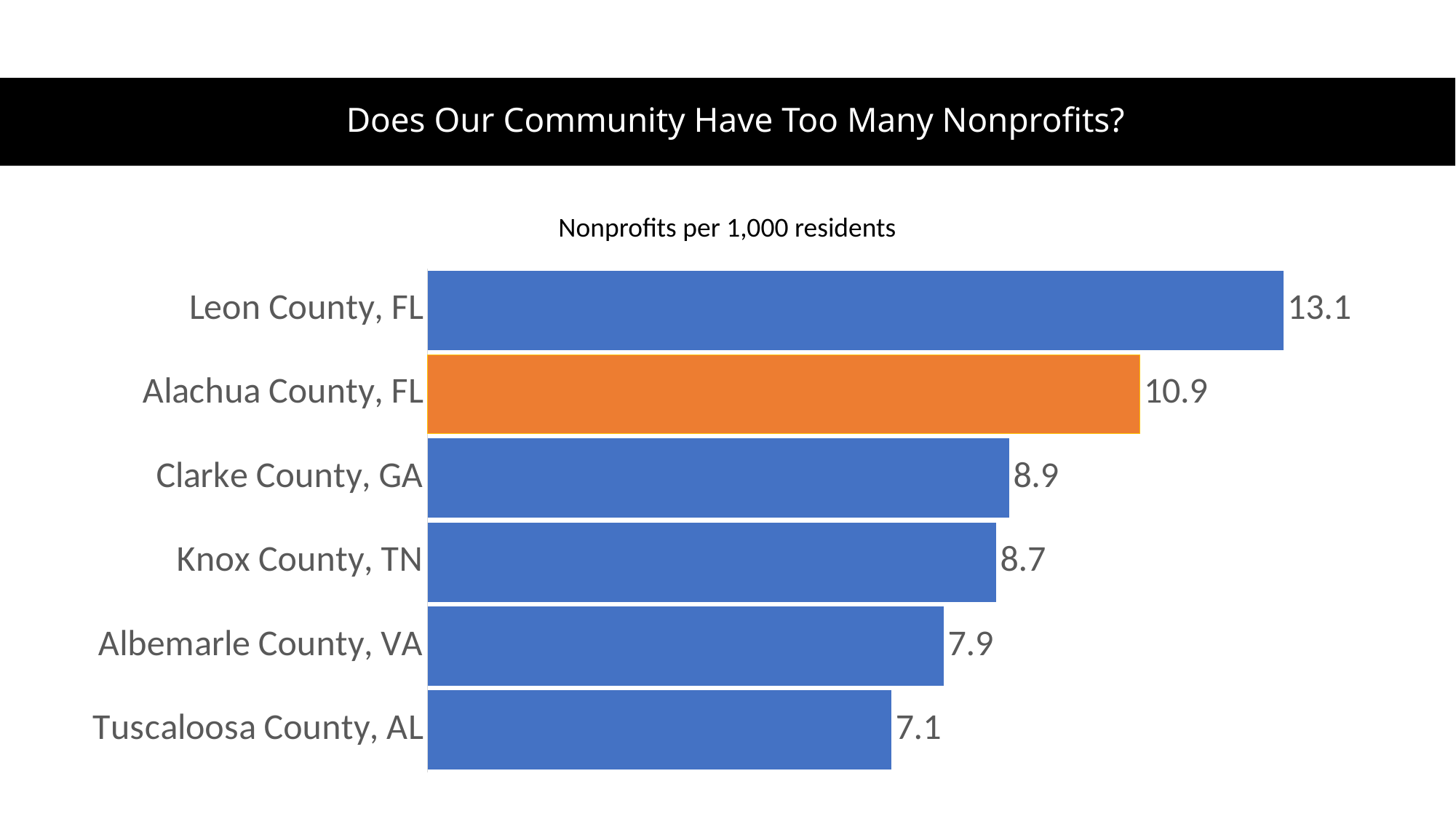
Which county's bar is coloured orange? Alachua County, FL What is the value for Alachua County, FL? 10.9 What is the difference between the values for Albemarle County, VA and Tuscaloosa County, AL? 0.8 Which county has the lowest number of nonprofits per 1,000 residents? Tuscaloosa County, AL Which county has the highest number of nonprofits per 1,000 residents? Leon County, FL What is the difference between the values for Leon County, FL and Alachua County, FL? 2.2 What kind of chart is shown on the slide? Bar chart What is the value for Tuscaloosa County, AL? 7.1 Which has a larger value, Clarke County, GA or Albemarle County, VA? Clarke County, GA How many counties are shown in the chart? 6 What is the value for Knox County, TN? 8.7 What is the title of the chart? Nonprofits per 1,000 residents